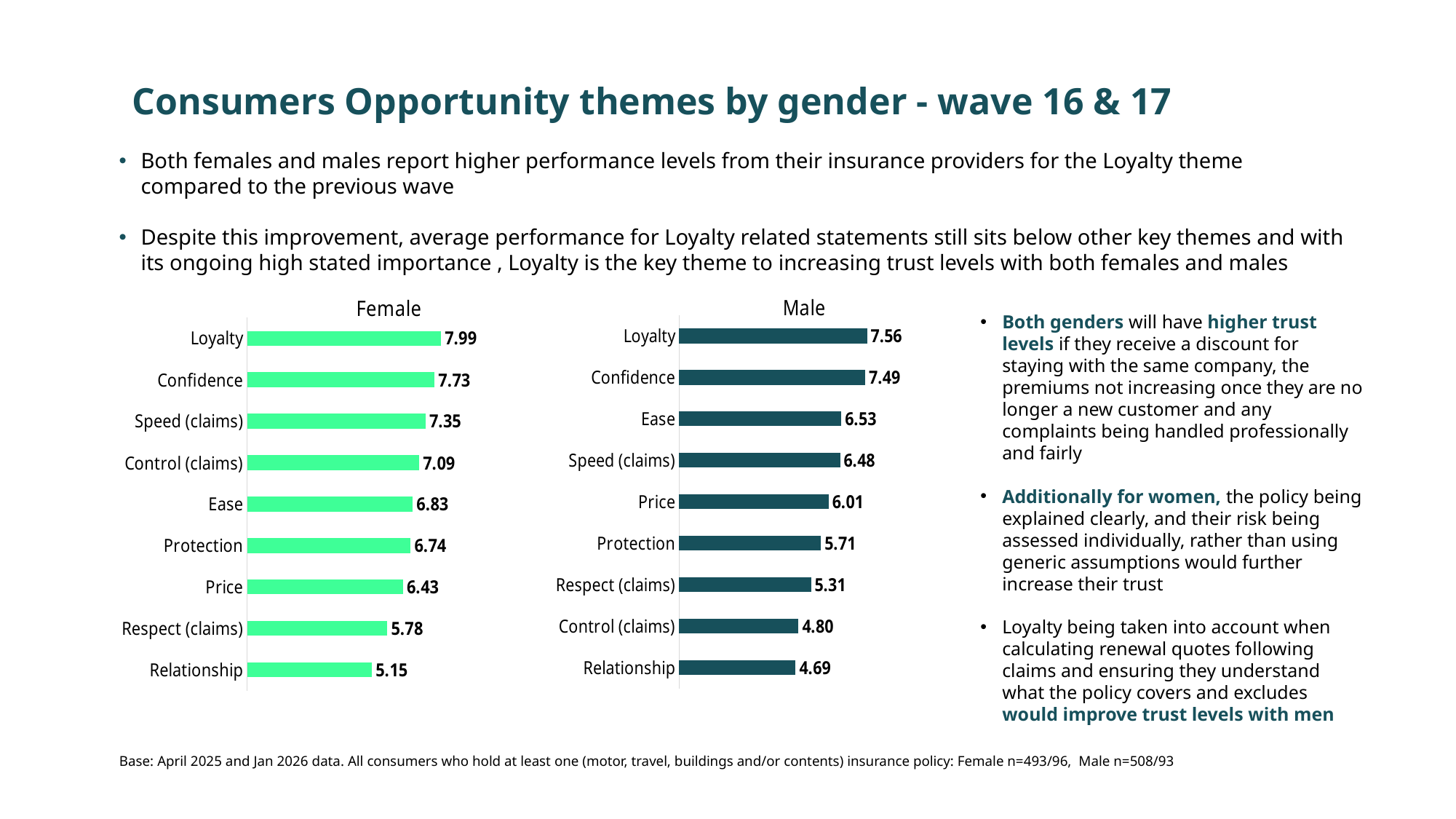
In the Male chart, what is the value for Ease? 6.53 In the Male chart, which theme has the lowest value? Relationship How many themes are plotted in the Female chart? 9 What type of chart is the Male chart? Bar chart Which is larger: the Female value for Control (claims) or the Male value for Control (claims)? Female (7.09) In the Female chart, which theme has the highest value? Loyalty In the Female chart, what is the difference between Loyalty and Relationship? 2.84 In the Male chart, what is the difference between Loyalty and Confidence? 0.07 What colour are the bars in the Female chart? Light green In the Female chart, what is the value for Loyalty? 7.99 In the Male chart, what is the value for Respect (claims)? 5.31 In the Male chart, is the value for Price greater or less than 6? greater